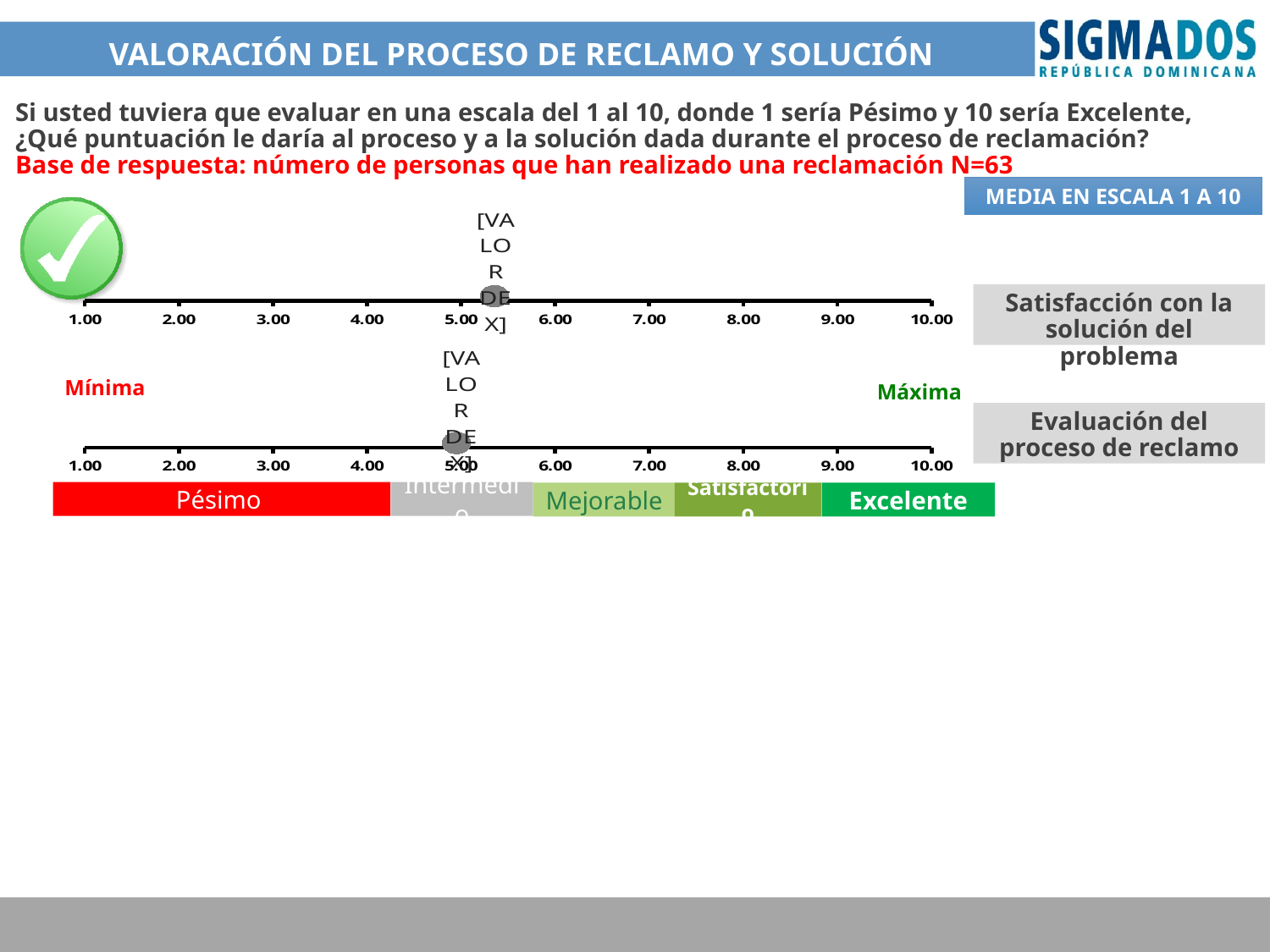
On the top chart (Satisfacción con la solución del problema), is the plotted value greater or less than 6.00? less On the bottom chart (Evaluación del proceso de reclamo), is the plotted value greater or less than 4.00? greater On the top chart (Satisfacción con la solución del problema), is the plotted value greater or less than 4.00? greater What is the highest tick label on the x axis of the top chart? 10.00 How many tick labels are shown on the x axis of the top chart? 10 What is the lowest tick label on the x axis of the bottom chart? 1.00 How many data points are plotted on the bottom chart (Evaluación del proceso de reclamo)? 1